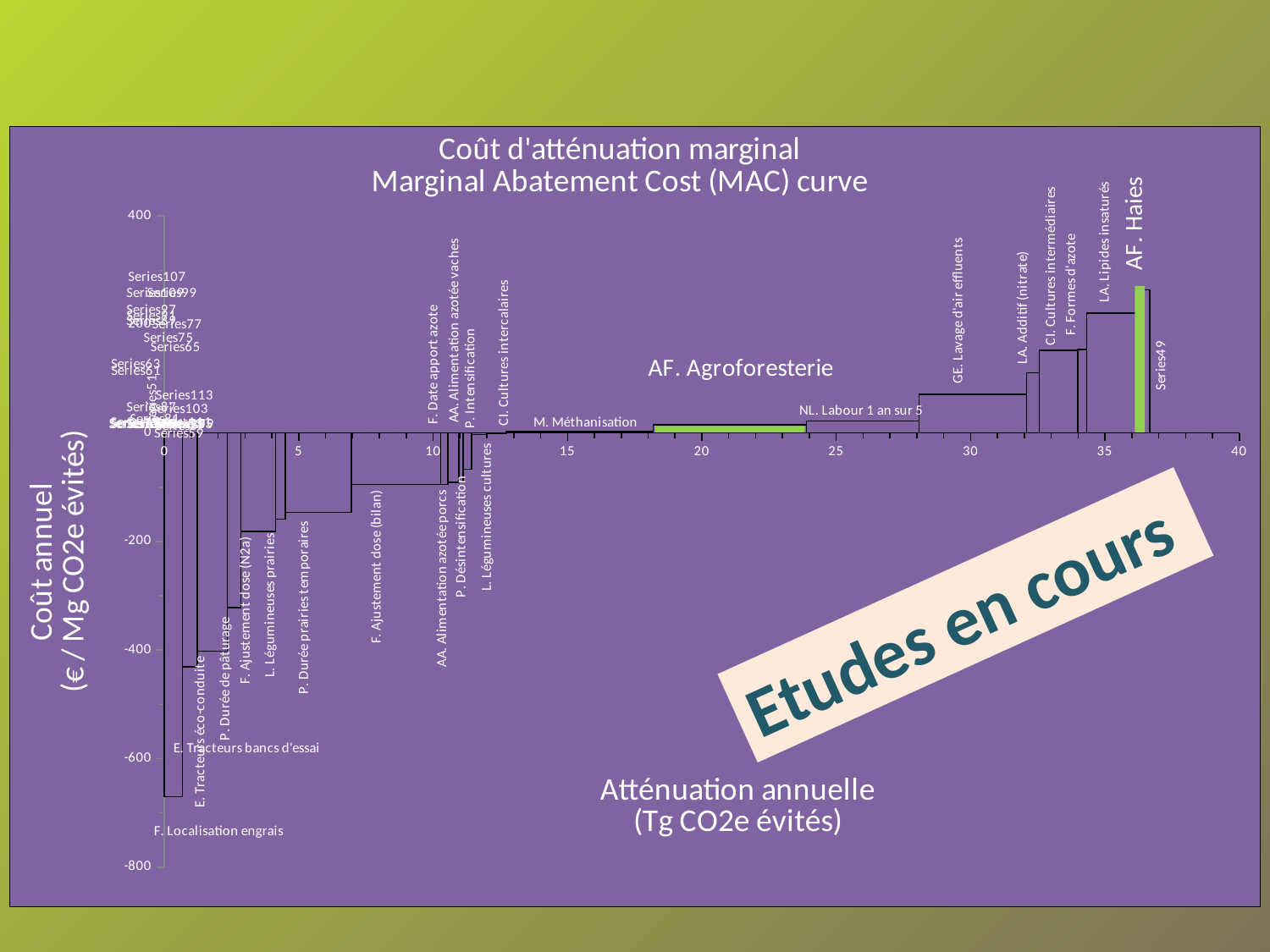
Which measure has the highest annual cost on the chart? AF. Haies Which has the higher annual cost, AF. Haies or LA. Lipides insaturés? AF. Haies Which measure has the lowest (most negative) annual cost on the chart? F. Localisation engrais Is the value for E. Tracteurs bancs d'essai greater or less than -400? less Is the value for F. Ajustement dose (bilan) greater or less than 0? less Is the value for GE. Lavage d'air effluents greater or less than 0? greater What kind of chart is shown on the slide? bar chart What is the title of the chart? Coût d'atténuation marginal / Marginal Abatement Cost (MAC) curve What is the label of the x axis? Atténuation annuelle (Tg CO2e évités)